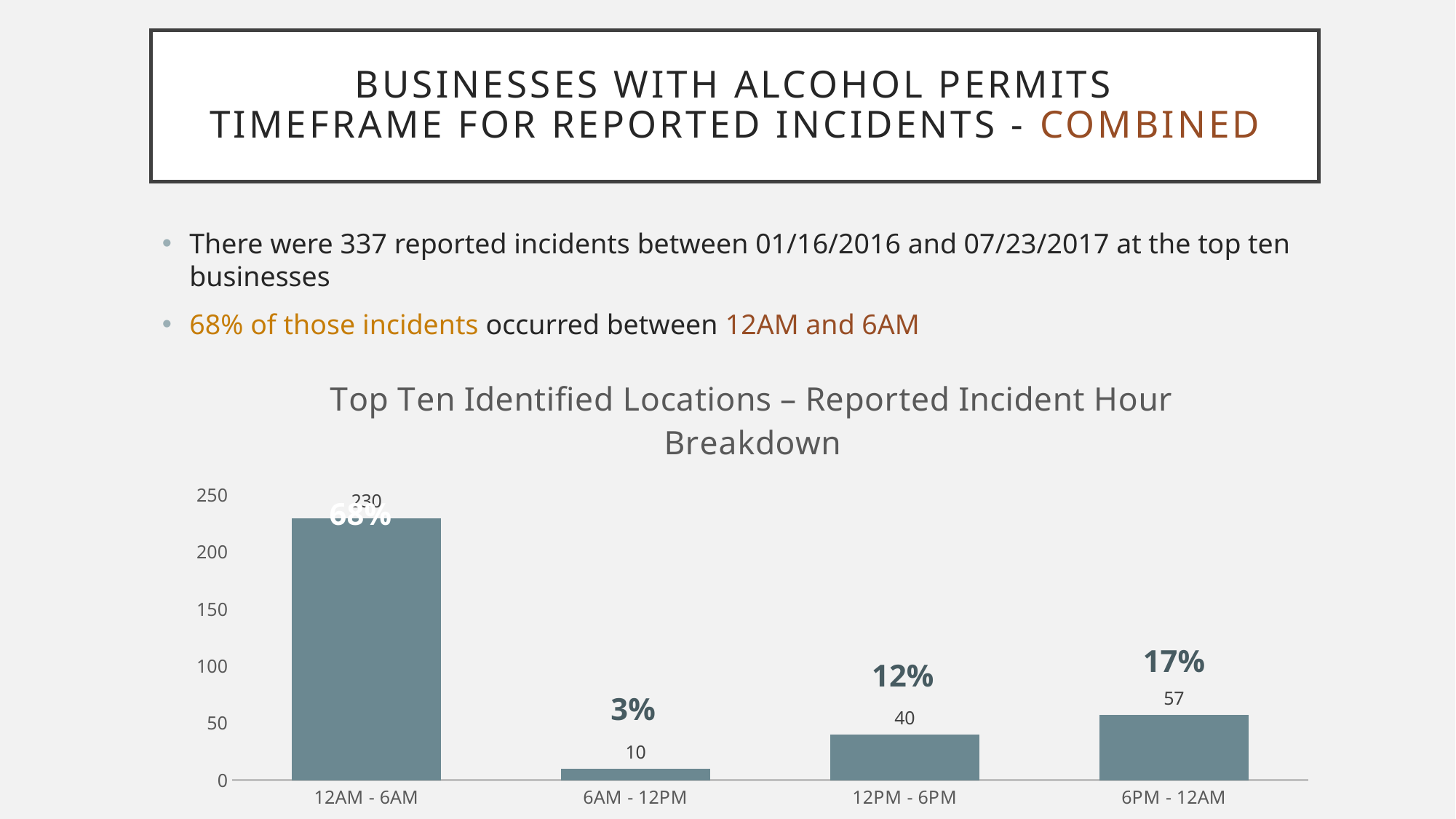
Which time period has the lowest number of reported incidents? 6AM - 12PM What is the value for 12AM - 6AM? 230 What kind of chart is shown on the slide? bar chart What percentage label is shown above the 6PM - 12AM bar? 17% What is the difference between the values for 6PM - 12AM and 12PM - 6PM? 17 Which is larger, the value for 12PM - 6PM or the value for 6PM - 12AM? 6PM - 12AM How many time periods are shown on the x axis? 4 Is the value for 12AM - 6AM greater or less than 200? greater What is the value for 6AM - 12PM? 10 What is the value for 6PM - 12AM? 57 What is the value for 12PM - 6PM? 40 Which time period has the highest number of reported incidents? 12AM - 6AM